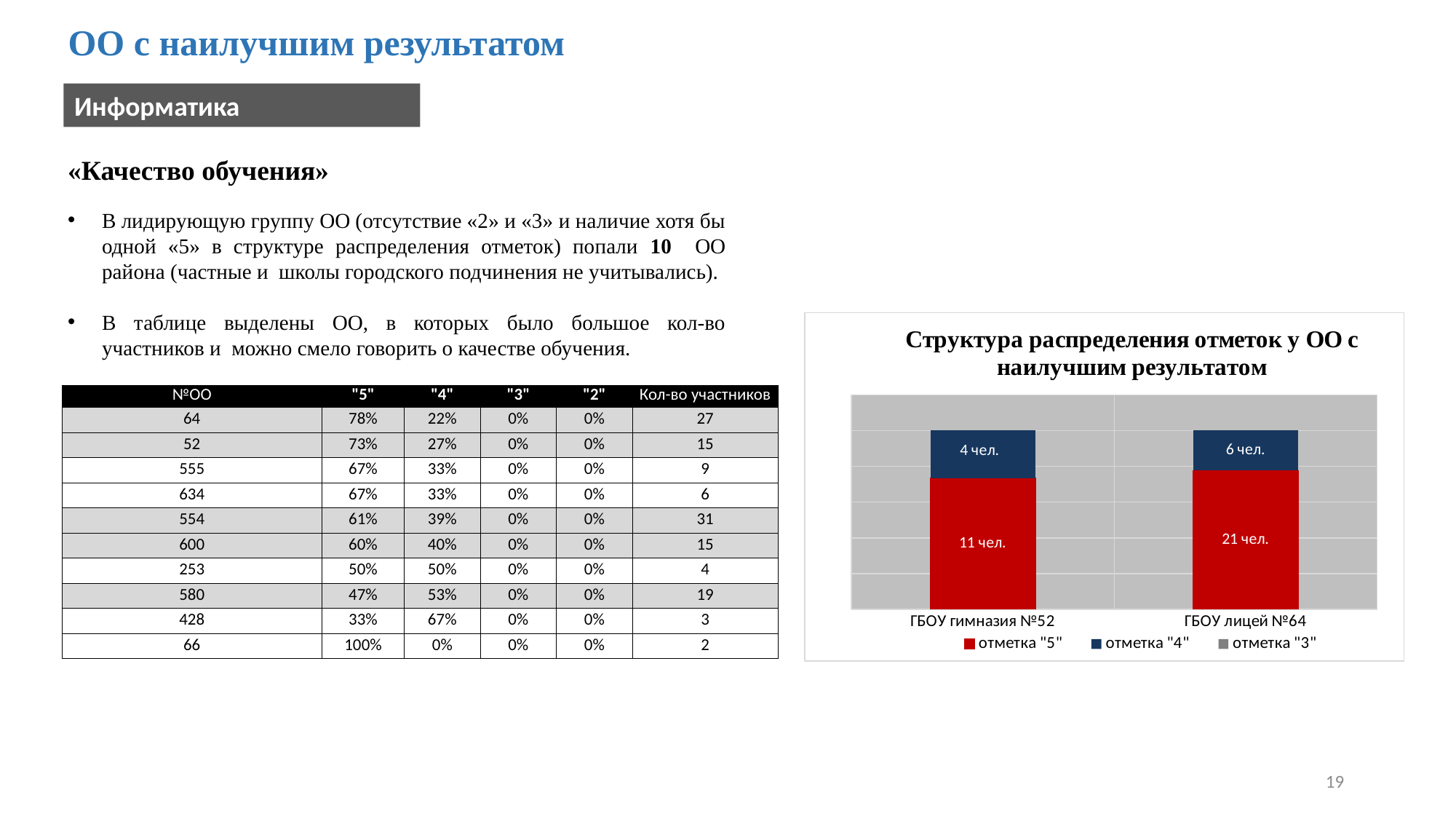
What is the value for отметка "5" at ГБОУ лицей №64? 21 чел. What is the difference between the отметка "5" values for ГБОУ лицей №64 and ГБОУ гимназия №52? 10 чел. What is the value for отметка "4" at ГБОУ лицей №64? 6 чел. What is the difference between the отметка "4" values for ГБОУ лицей №64 and ГБОУ гимназия №52? 2 чел. Which colour represents отметка "5" in the chart? red How many categories (schools) are shown on the x axis of the chart? 2 What is the value for отметка "4" at ГБОУ гимназия №52? 4 чел. What kind of chart is shown on the slide? stacked bar chart How many series does the chart legend list? 3 What is the value for отметка "5" at ГБОУ гимназия №52? 11 чел. What is the title of the chart? Структура распределения отметок у ОО с наилучшим результатом Which school has the larger value for отметка "5"? ГБОУ лицей №64